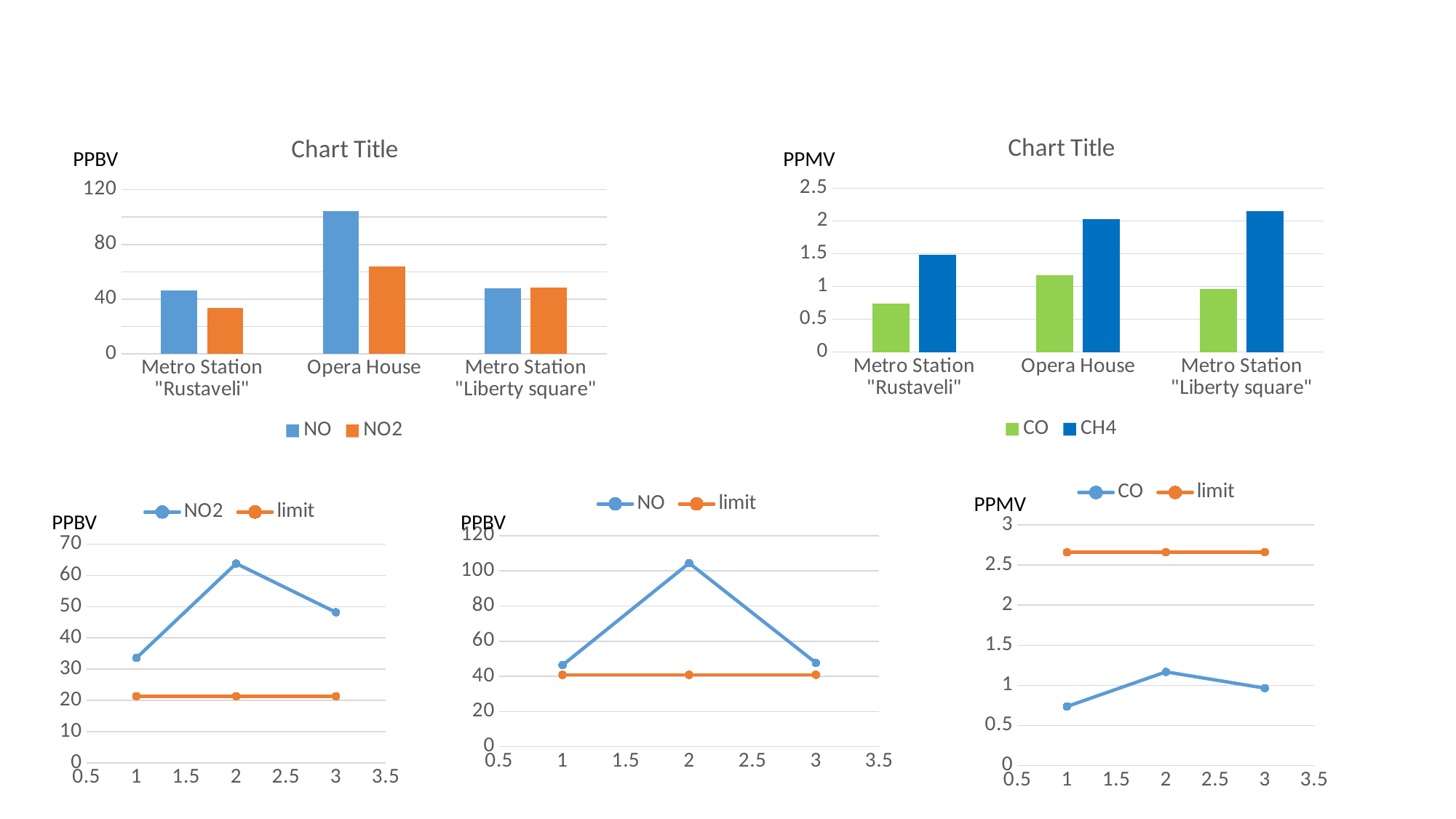
In the bottom-left line chart, does the NO2 line rise or fall from x = 2 to x = 3? fall In the top-left bar chart, which category has the lowest NO2 value? Metro Station "Rustaveli" In the top-right bar chart, is the CH4 value for Metro Station "Rustaveli" greater or less than 2? less In the top-right bar chart, which is larger at Opera House, CO or CH4? CH4 How many series does the legend of the top-right bar chart list? 2 What kind of chart is the bottom-middle chart showing NO and limit? line chart How many categories are shown on the x axis of the top-left bar chart? 3 In the top-right bar chart, which category has the highest CO value? Opera House In the bottom-right line chart, is the CO line above or below the limit line at every point? below In the top-left bar chart, is the NO2 value for Metro Station "Rustaveli" greater or less than 40? less In the top-left bar chart, which category has the highest NO value? Opera House In the top-left bar chart, is the NO value for Opera House greater or less than 80? greater